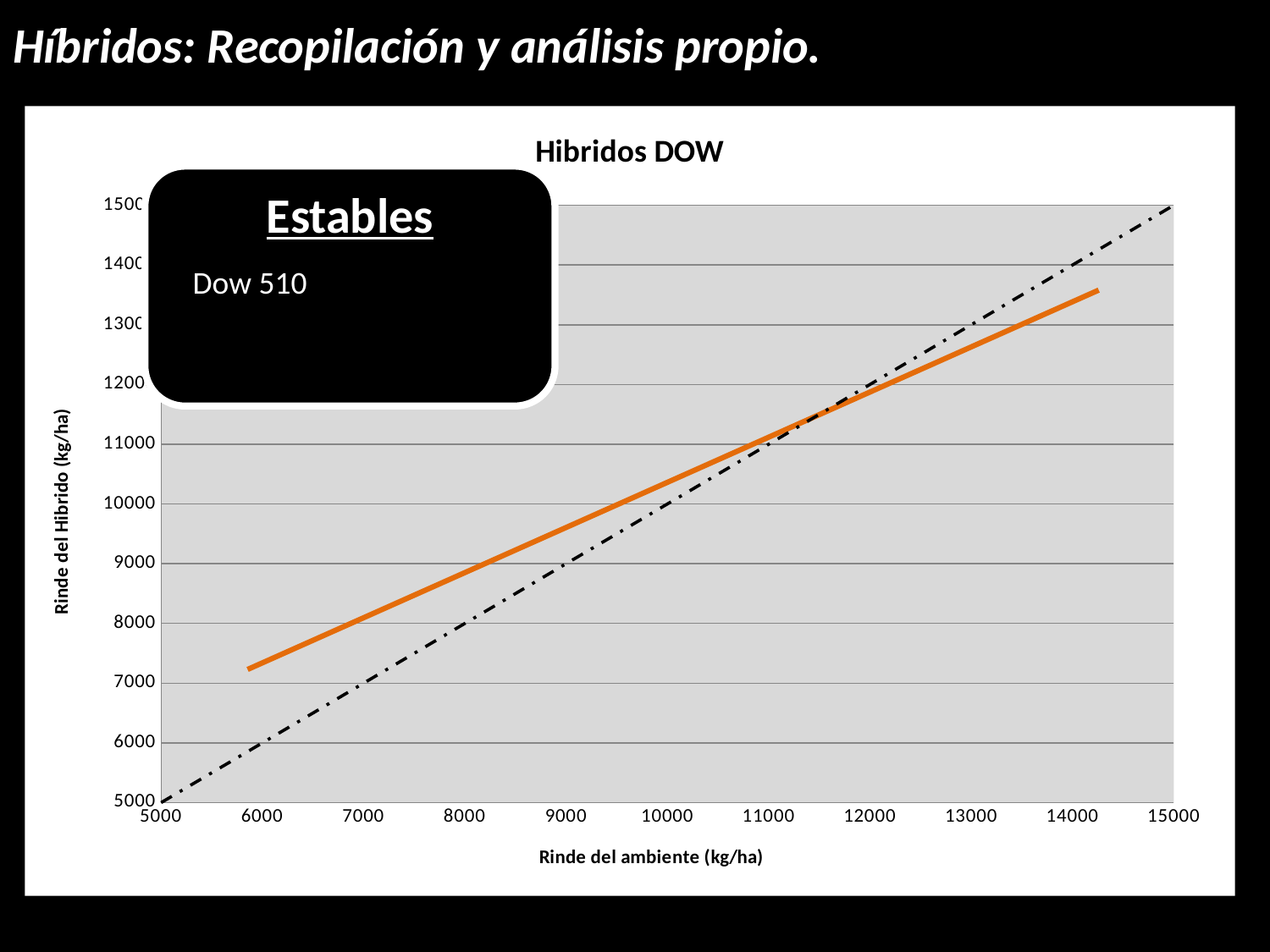
At a Rinde del ambiente of 14000, which is higher: the orange line or the dashed line? the dashed line Does the orange line rise or fall as Rinde del ambiente increases? rise What is the highest value shown on the x axis of the chart? 15000 Is the value of the orange line at a Rinde del ambiente of 13000 greater or less than 12000? greater What is the label of the x axis of the chart? Rinde del ambiente (kg/ha) What kind of chart is shown on the slide? line chart Is the value of the orange line at a Rinde del ambiente of 14000 greater or less than 14000? less What is the title of the chart? Hibridos DOW Is the value of the orange line at a Rinde del ambiente of 8000 greater or less than 8000? greater At a Rinde del ambiente of 8000, which is higher: the orange line or the dashed line? the orange line